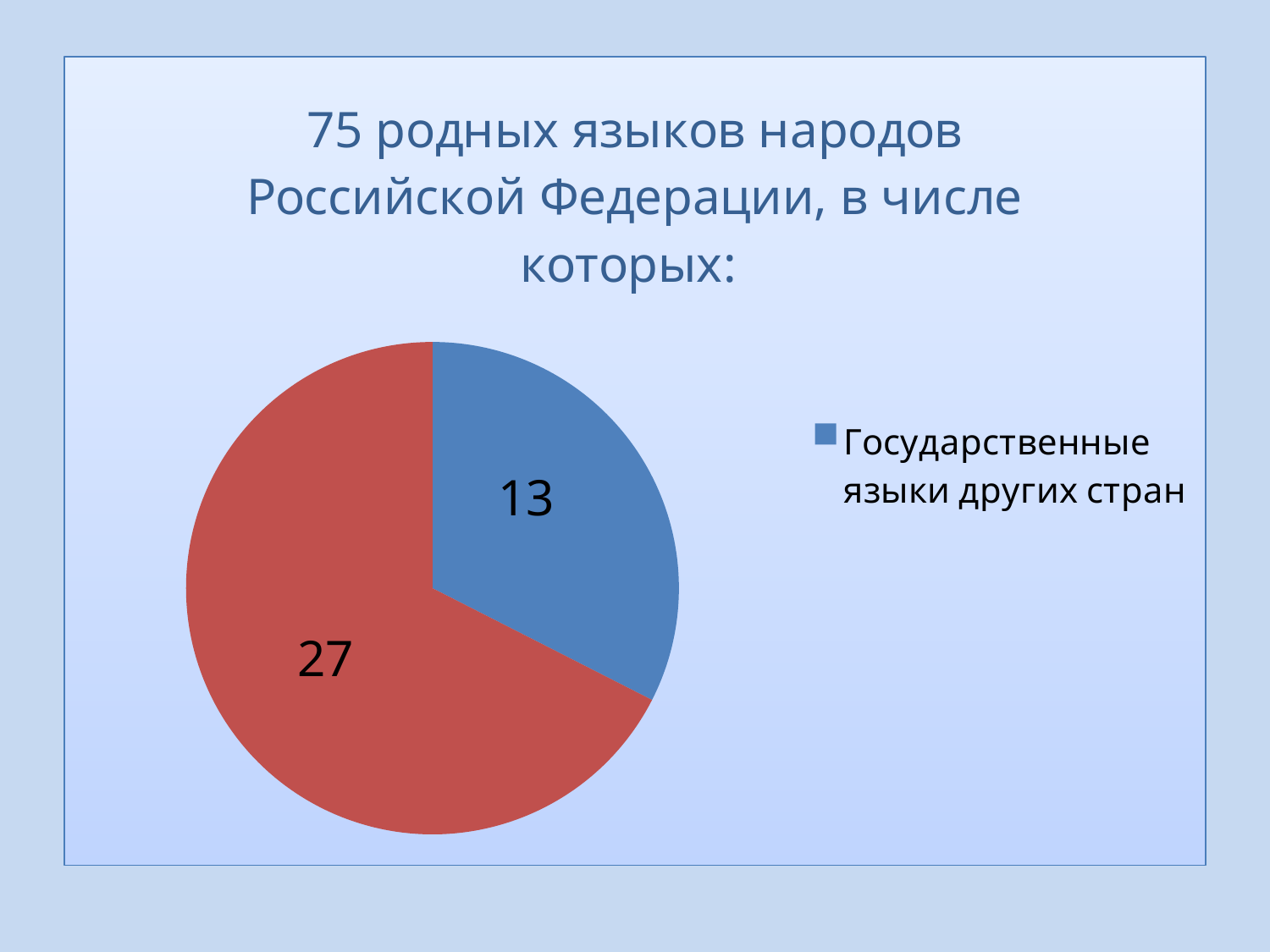
What is the value of the smallest slice in the pie chart? 13 What is the value for "Государственные языки других стран" in the pie chart? 13 What share of the pie does the slice labelled 13 represent? 32.5% What is the difference between the red slice (27) and the blue slice (13) in the pie chart? 14 How many entries does the legend of the pie chart list? 1 Which slice is larger in the pie chart, the blue one or the red one? the red one What kind of chart is shown on the slide? pie chart How many slices does the pie chart have? 2 What colour is the slice for "Государственные языки других стран" in the pie chart? blue What is the total of the two slice values shown in the pie chart? 40 What value is printed on the red slice of the pie chart? 27 What is the value of the largest slice in the pie chart? 27